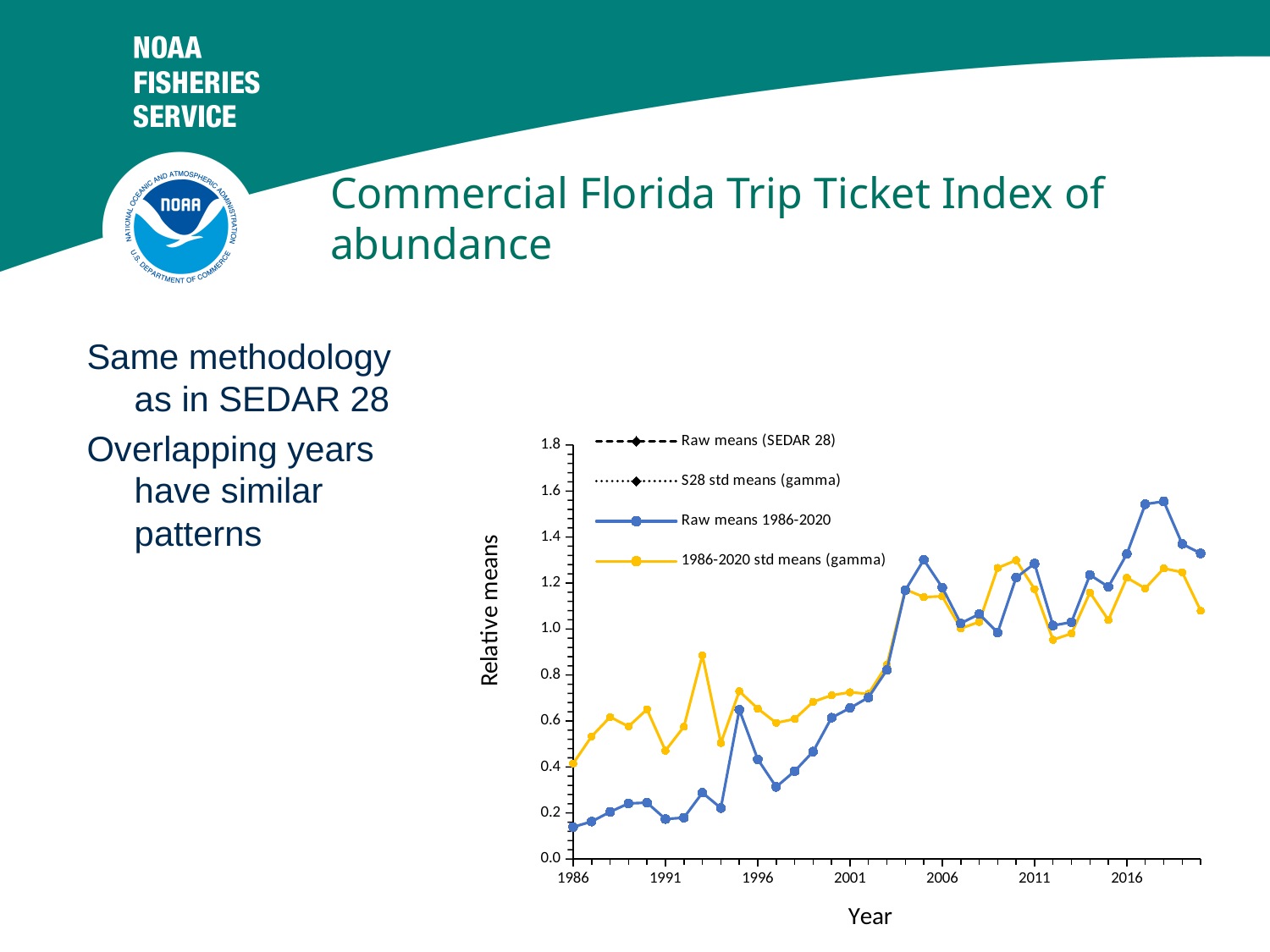
In 2017, which series has the larger value: 'Raw means 1986-2020' or '1986-2020 std means (gamma)'? Raw means 1986-2020 How many series does the chart's legend list? 4 What kind of chart is shown on the slide? Line chart What is the title of the chart's x axis? Year Is the value of the 'Raw means 1986-2020' series in 1997 greater or less than 0.4? less Is the value of the '1986-2020 std means (gamma)' series in 1993 greater or less than 0.8? greater Overall, does the 'Raw means 1986-2020' series rise or fall from 1986 to 2020? Rise What is the title of the chart's y axis? Relative means Is the value of the 'Raw means 1986-2020' series in 2017 greater or less than 1.4? greater In 1986, which series has the larger value: 'Raw means 1986-2020' or '1986-2020 std means (gamma)'? 1986-2020 std means (gamma)